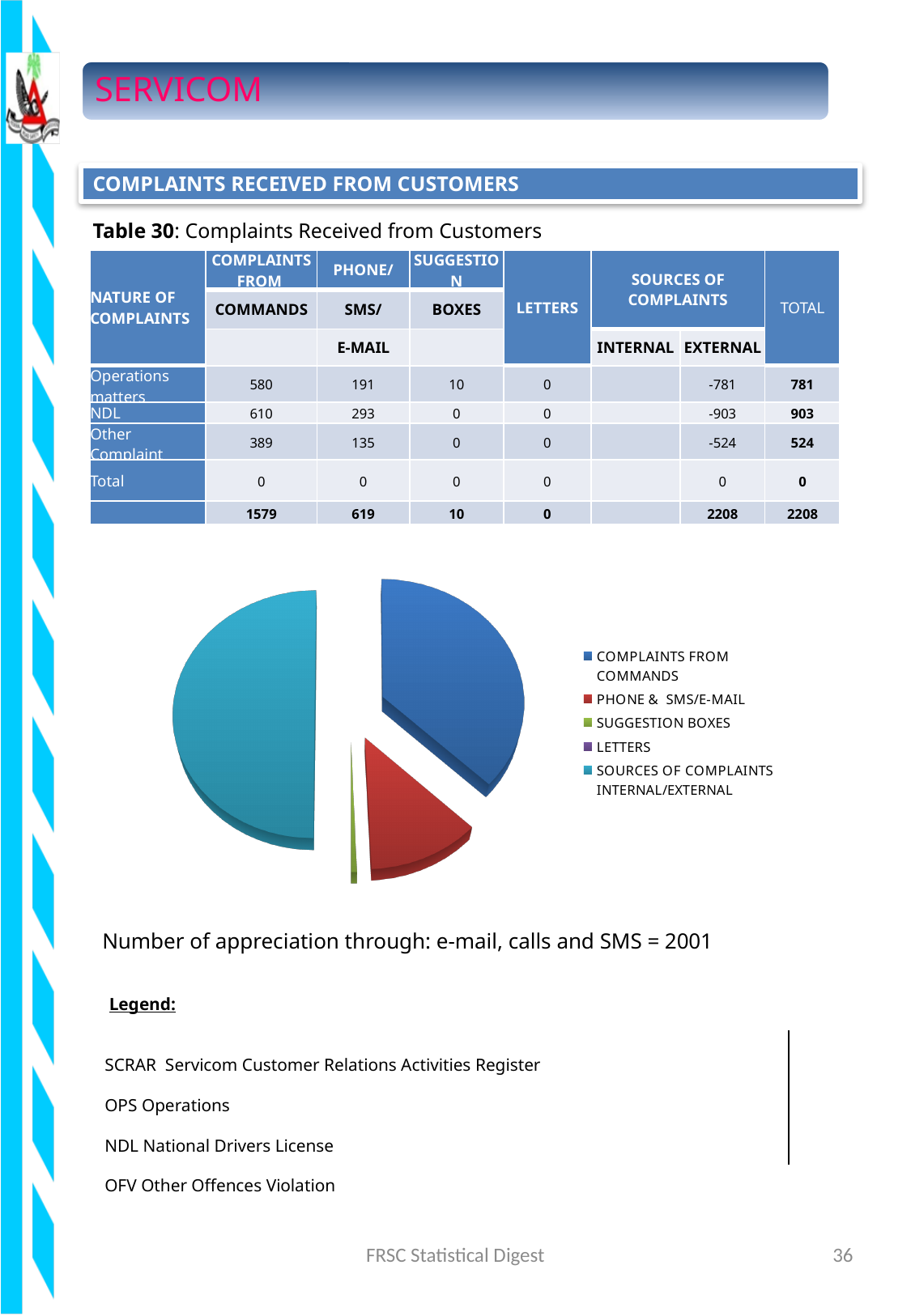
How many entries does the pie chart's legend list? 5 What colour represents PHONE & SMS/E-MAIL in the pie chart? Red Which category has the largest slice in the pie chart? SOURCES OF COMPLAINTS INTERNAL/EXTERNAL In the pie chart, which slice is larger: SOURCES OF COMPLAINTS INTERNAL/EXTERNAL or COMPLAINTS FROM COMMANDS? SOURCES OF COMPLAINTS INTERNAL/EXTERNAL What kind of chart is shown on the slide? Pie chart In the pie chart, which slice is larger: COMPLAINTS FROM COMMANDS or PHONE & SMS/E-MAIL? COMPLAINTS FROM COMMANDS In the pie chart, which slice is larger: PHONE & SMS/E-MAIL or SUGGESTION BOXES? PHONE & SMS/E-MAIL Which legend entry is shown in green in the pie chart? SUGGESTION BOXES